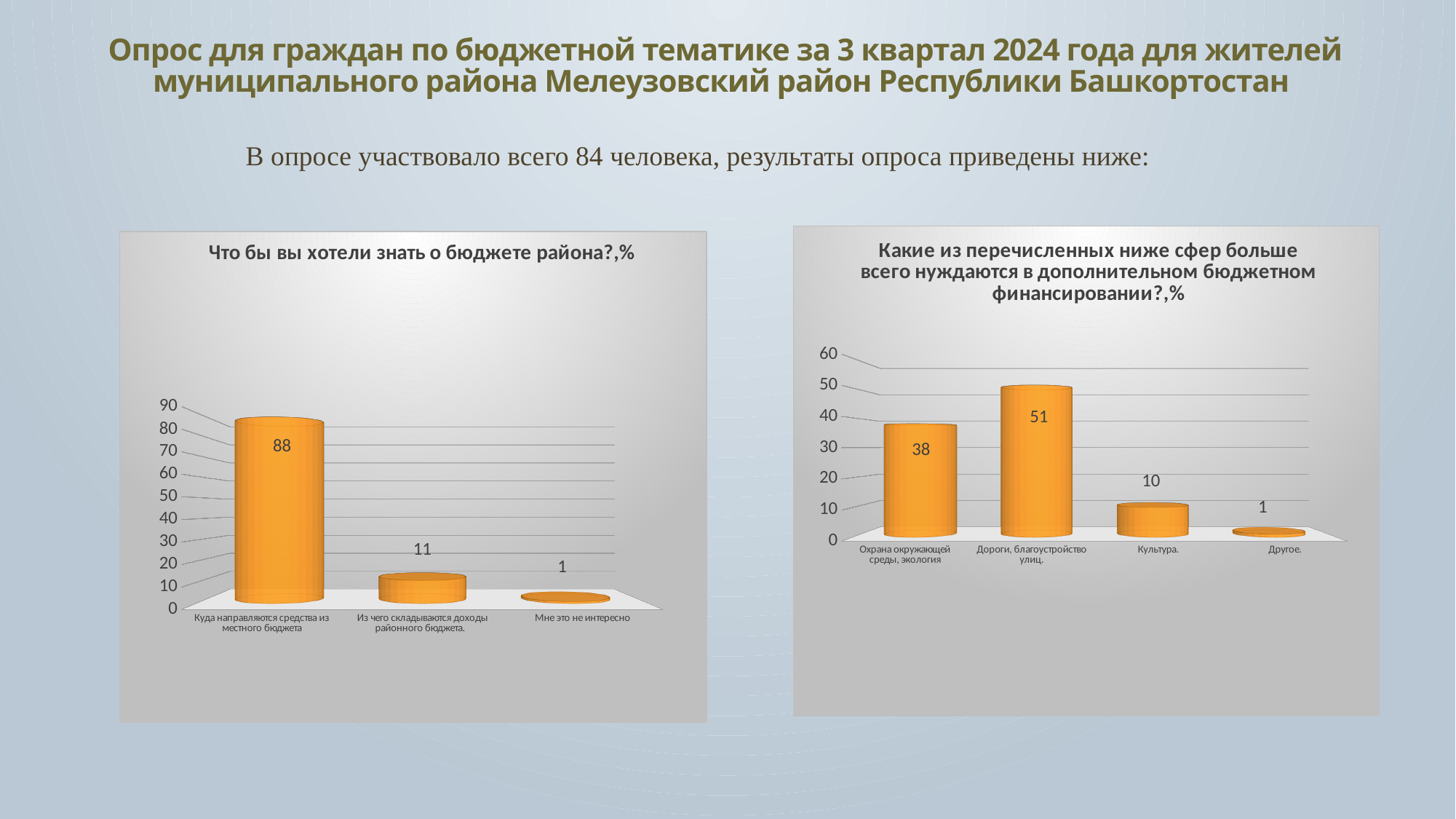
In the right chart 'Какие из перечисленных ниже сфер больше всего нуждаются в дополнительном бюджетном финансировании?,%', what is the value for 'Дороги, благоустройство улиц.'? 51 How many categories are shown in the right chart 'Какие из перечисленных ниже сфер больше всего нуждаются в дополнительном бюджетном финансировании?,%'? 4 How many categories are shown in the left chart 'Что бы вы хотели знать о бюджете района?,%'? 3 What type of chart is the left chart 'Что бы вы хотели знать о бюджете района?,%'? Bar chart In the right chart 'Какие из перечисленных ниже сфер больше всего нуждаются в дополнительном бюджетном финансировании?,%', what is the difference between the values for 'Дороги, благоустройство улиц.' and 'Охрана окружающей среды, экология'? 13 In the right chart 'Какие из перечисленных ниже сфер больше всего нуждаются в дополнительном бюджетном финансировании?,%', which category has the lowest value? Другое. In the left chart 'Что бы вы хотели знать о бюджете района?,%', what is the value for 'Куда направляются средства из местного бюджета'? 88 In the right chart 'Какие из перечисленных ниже сфер больше всего нуждаются в дополнительном бюджетном финансировании?,%', what is the value for 'Культура.'? 10 In the left chart 'Что бы вы хотели знать о бюджете района?,%', what is the value for 'Мне это не интересно'? 1 In the left chart 'Что бы вы хотели знать о бюджете района?,%', which category has the highest value? Куда направляются средства из местного бюджета In the right chart 'Какие из перечисленных ниже сфер больше всего нуждаются в дополнительном бюджетном финансировании?,%', which is larger: 'Охрана окружающей среды, экология' or 'Дороги, благоустройство улиц.'? Дороги, благоустройство улиц. In the left chart 'Что бы вы хотели знать о бюджете района?,%', what is the difference between the values for 'Куда направляются средства из местного бюджета' and 'Из чего складываются доходы районного бюджета.'? 77